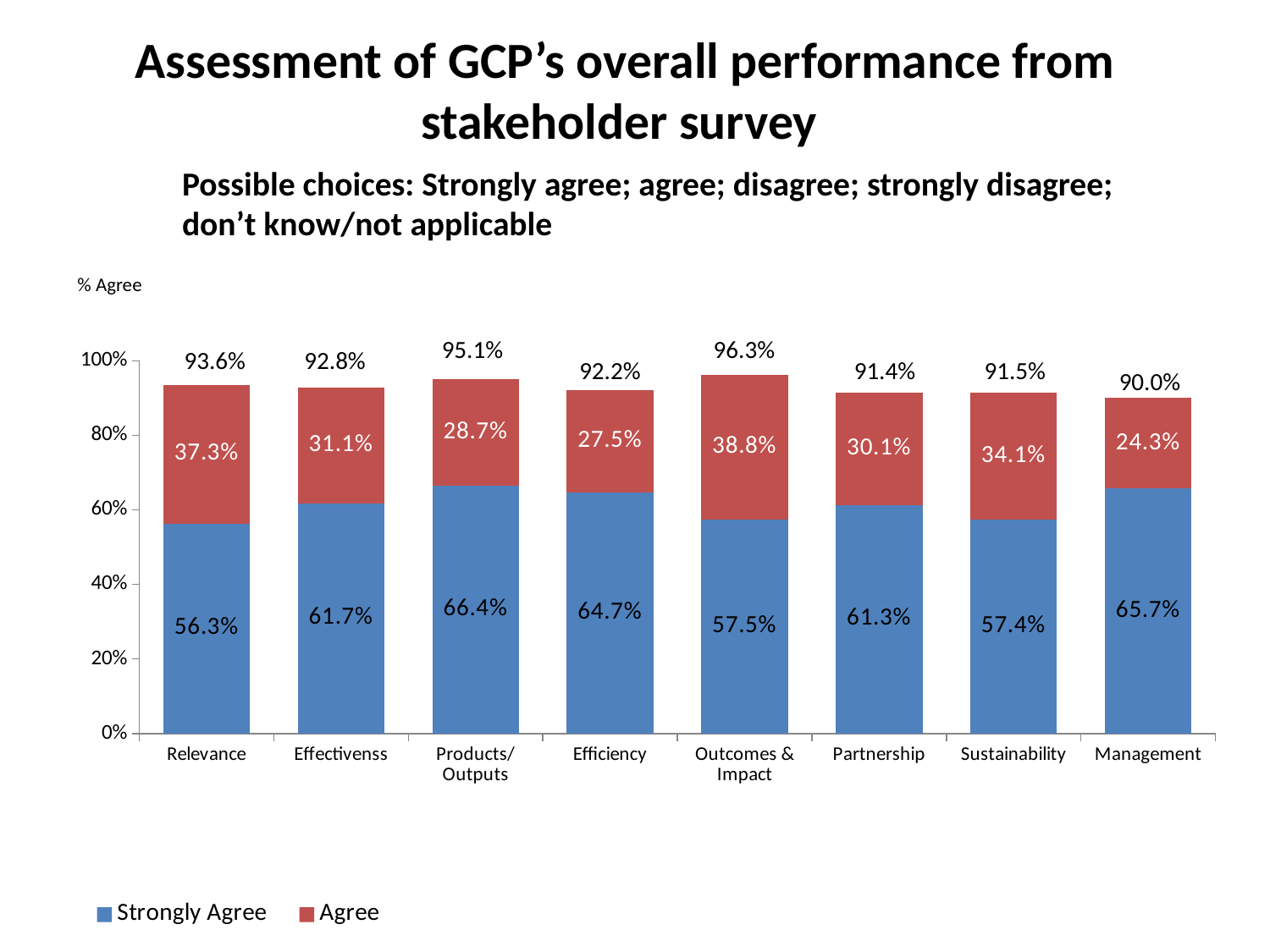
How many categories are shown on the x axis? 8 What kind of chart is shown on the slide? Stacked bar chart What is the difference between the Strongly Agree values for Products/Outputs and Sustainability? 9.0% What is the Agree value for Outcomes & Impact? 38.8% Which is larger, the Agree value for Relevance or the Agree value for Management? Relevance Is the Strongly Agree value for Efficiency greater or less than 60%? greater Which category has the lowest Strongly Agree value? Relevance What is the Strongly Agree value for Relevance? 56.3% What is the total % Agree shown above the Management bar? 90.0% Which colour represents the Agree series? Red Which category has the highest total % Agree? Outcomes & Impact How many series does the legend list? 2